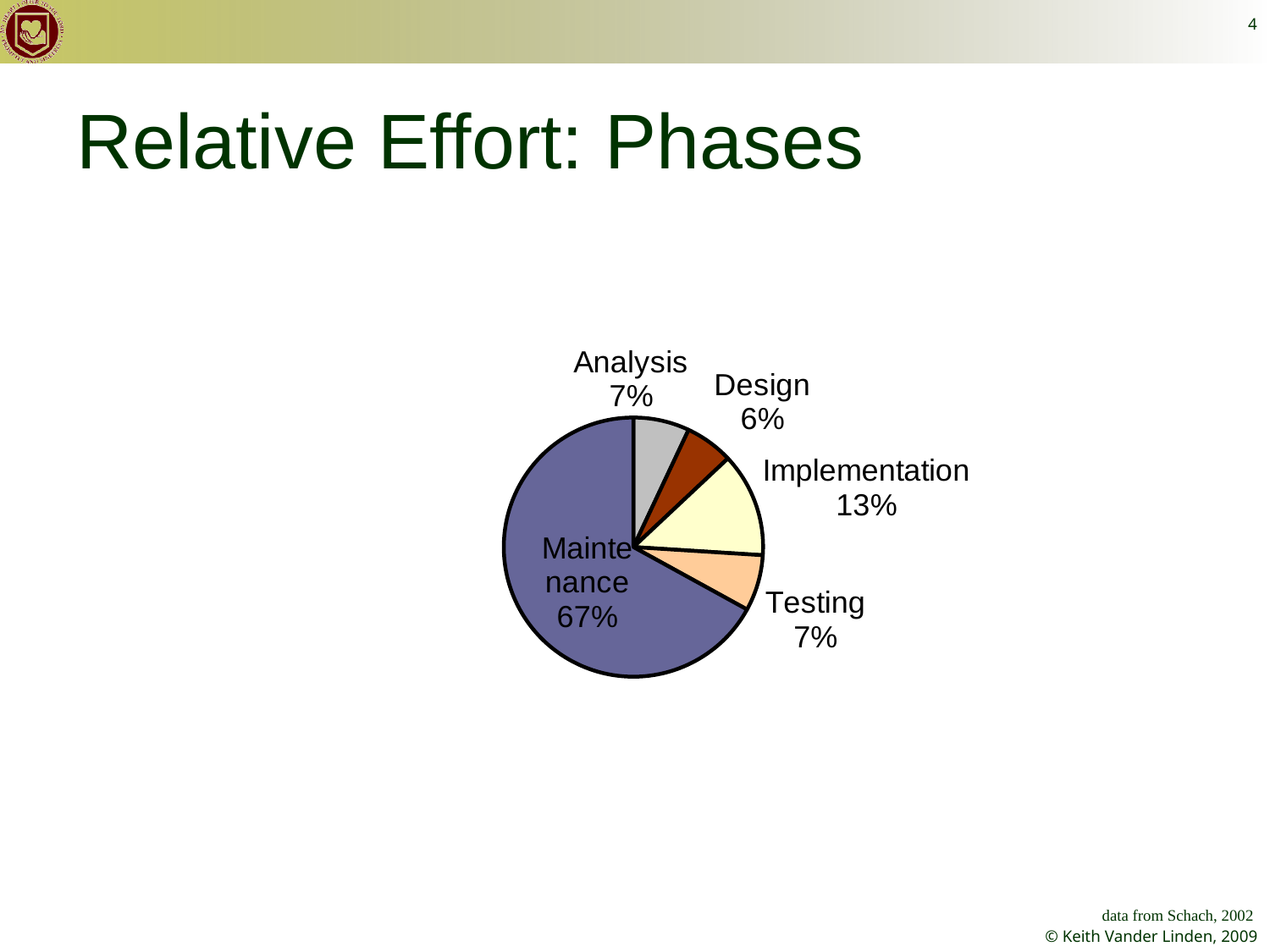
What is the difference in percentage points between Maintenance and Implementation? 54 What percentage of effort is attributed to Testing? 7% What percentage of effort is attributed to Implementation? 13% Which phase has the largest share of effort? Maintenance What percentage of effort is attributed to Design? 6% How many phases (slices) are shown in the pie chart? 5 What kind of chart is shown on the slide? pie chart Which is larger, the share for Implementation or the share for Analysis? Implementation What is the title of the slide containing the chart? Relative Effort: Phases What is the combined share of Analysis and Design? 13% What percentage of effort is attributed to Maintenance? 67% Which phase has the smallest share of effort? Design